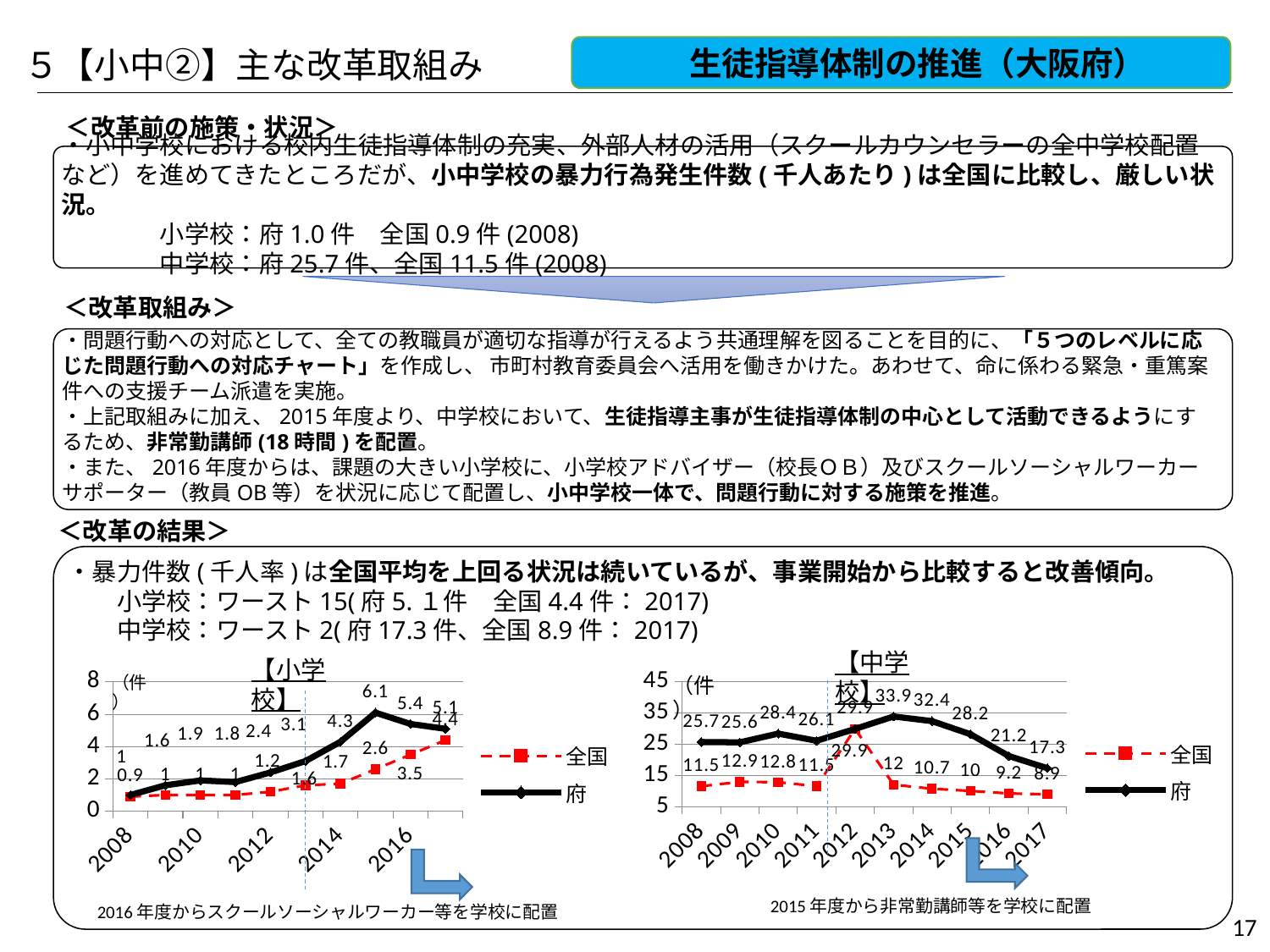
In the 【小学校】 chart, what is the highest value reached by the 府 series? 6.1 In the 【中学校】 chart, in which year does the 府 series reach its highest value? 2013 In the 【中学校】 chart, what is the value for 全国 in 2017? 8.9 In the 【小学校】 chart, what is the value for 府 in 2016? 5.4 What type of chart is the 【小学校】 chart on the left? line chart In the 【中学校】 chart, does the 府 series rise or fall from 2013 to 2017? fall In the 【小学校】 chart, what is the value for 全国 in 2016? 3.5 How many series does the legend of the 【中学校】 chart list? 2 In the 【中学校】 chart, which series has the larger value in 2016, 府 or 全国? 府 In the 【中学校】 chart, what is the value for 府 in 2017? 17.3 In the 【小学校】 chart, what is the difference between 府 and 全国 in 2014? 2.6 In the 【中学校】 chart, what is the difference between 府 and 全国 in 2008? 14.2